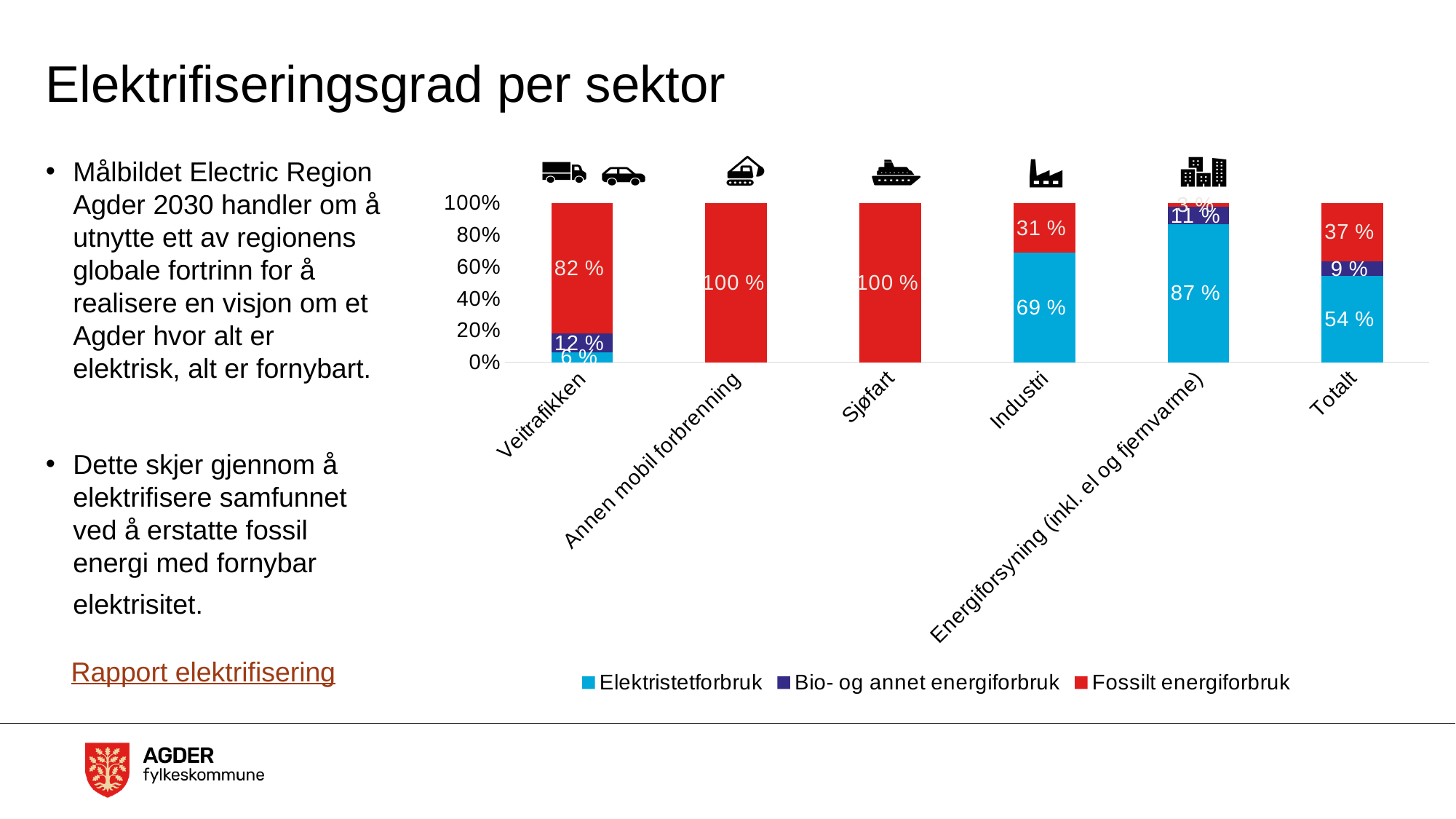
How many sectors (categories) are shown on the x axis of the chart? 6 How many series does the chart legend list? 3 What is the Elektristetforbruk share for Industri? 69 % What type of chart is shown on the slide? stacked bar chart Is the Elektristetforbruk share for Veitrafikken greater or less than 20%? less What is the difference between the Elektristetforbruk share for Energiforsyning (inkl. el og fjernvarme) and for Totalt? 33 % Which series is shown in red in the chart? Fossilt energiforbruk What is the Bio- og annet energiforbruk share for Totalt? 9 % Which of Industri or Totalt has the larger Fossilt energiforbruk share? Totalt Which sector has the highest Elektristetforbruk share? Energiforsyning (inkl. el og fjernvarme) What is the Fossilt energiforbruk share for Veitrafikken? 82 % What is the Fossilt energiforbruk share for Sjøfart? 100 %